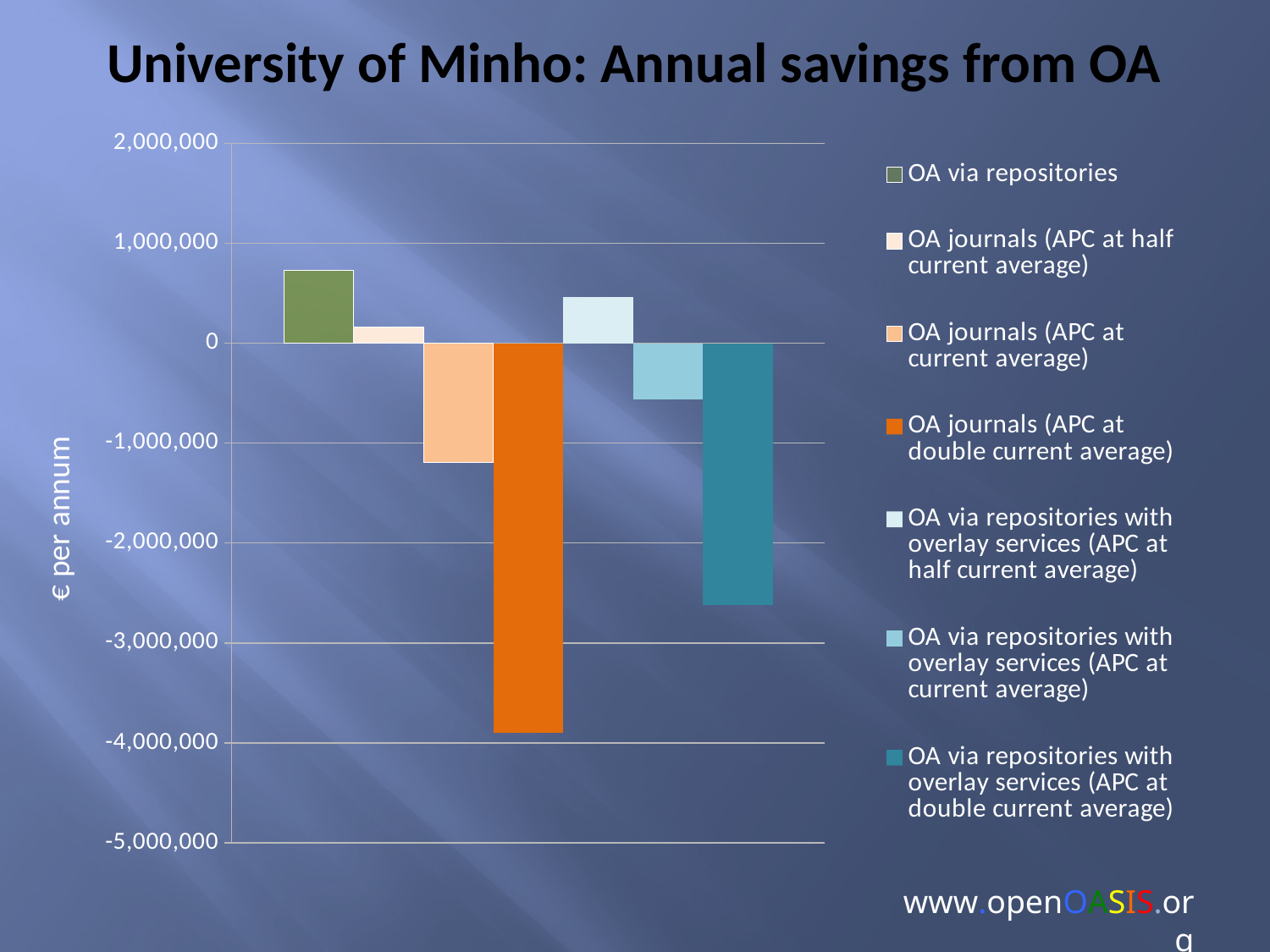
Is the value for OA via repositories with overlay services (APC at double current average) greater or less than -3,000,000? greater Which is larger: the value for OA via repositories with overlay services (APC at current average) or the value for OA journals (APC at current average)? OA via repositories with overlay services (APC at current average) Is the value for OA journals (APC at double current average) greater or less than -3,000,000? less Is the value for OA journals (APC at current average) greater or less than -1,000,000? less How many series does the legend list? 7 What is the label on the vertical axis? € per annum What kind of chart is shown on the slide? bar chart Which is larger: the value for OA via repositories or the value for OA journals (APC at half current average)? OA via repositories Which series has the highest (most positive) value? OA via repositories Which series has the lowest (most negative) value? OA journals (APC at double current average) What is the title of the chart? University of Minho: Annual savings from OA